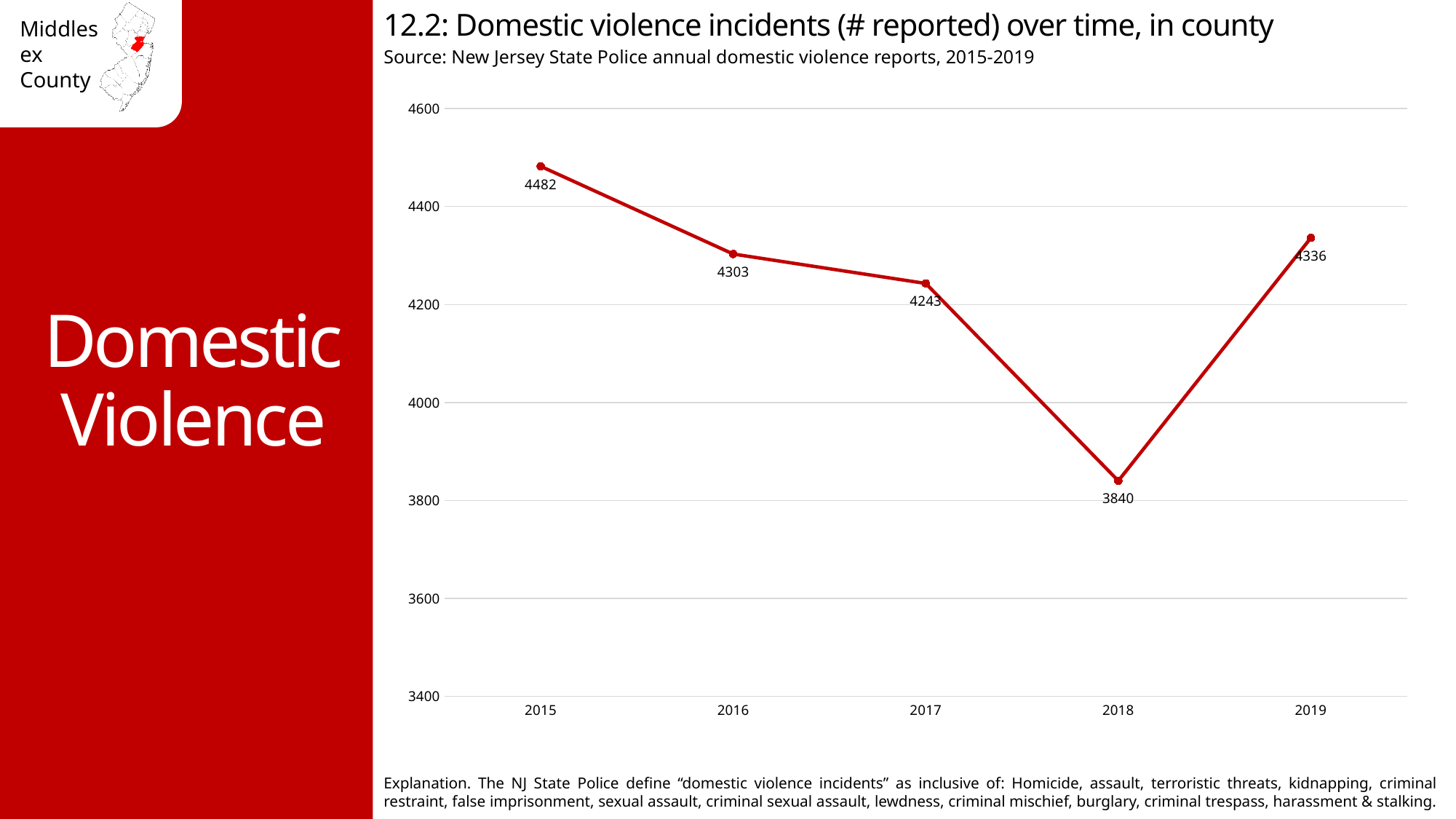
Which year had the highest number of reported domestic violence incidents? 2015 Did the number of reported incidents rise or fall from 2015 to 2018? Fall Is the value for 2017 greater or less than 4200? greater How many years are plotted on the chart? 5 What was the number of reported domestic violence incidents in 2015? 4482 Which year had the lowest number of reported domestic violence incidents? 2018 Which year had more reported incidents, 2016 or 2019? 2019 What is the difference between the number of incidents in 2019 and 2018? 496 What is the difference between the number of incidents in 2015 and 2018? 642 What was the number of reported domestic violence incidents in 2019? 4336 What was the number of reported domestic violence incidents in 2018? 3840 What kind of chart is shown on the slide? Line chart